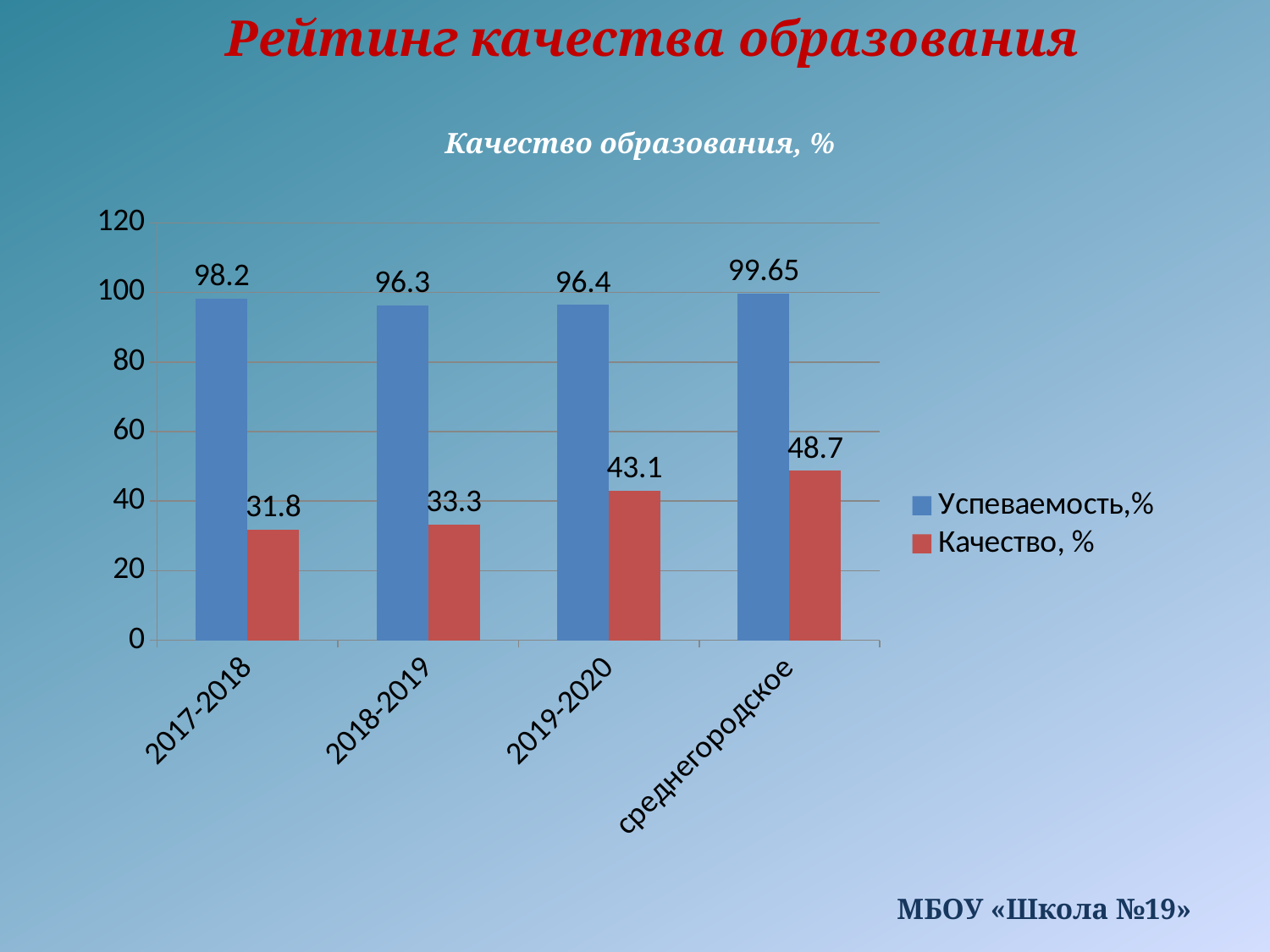
How many categories are shown on the x axis? 4 Does the value of Качество, % rise or fall from 2017-2018 to 2019-2020? rise Is the value of Качество, % for 2017-2018 greater or less than 40? less What is the difference between Качество, % for 2019-2020 and 2018-2019? 9.8 What is the value of Успеваемость,% for 2017-2018? 98.2 How many series does the legend list? 2 Which is larger: Успеваемость,% for 2017-2018 or for 2019-2020? 2017-2018 What kind of chart is shown on the slide? bar chart Which category has the lowest value for Успеваемость,%? 2018-2019 What is the value of Качество, % for 2019-2020? 43.1 Which category has the highest value for Качество, %? среднегородское What is the value of Качество, % for среднегородское? 48.7